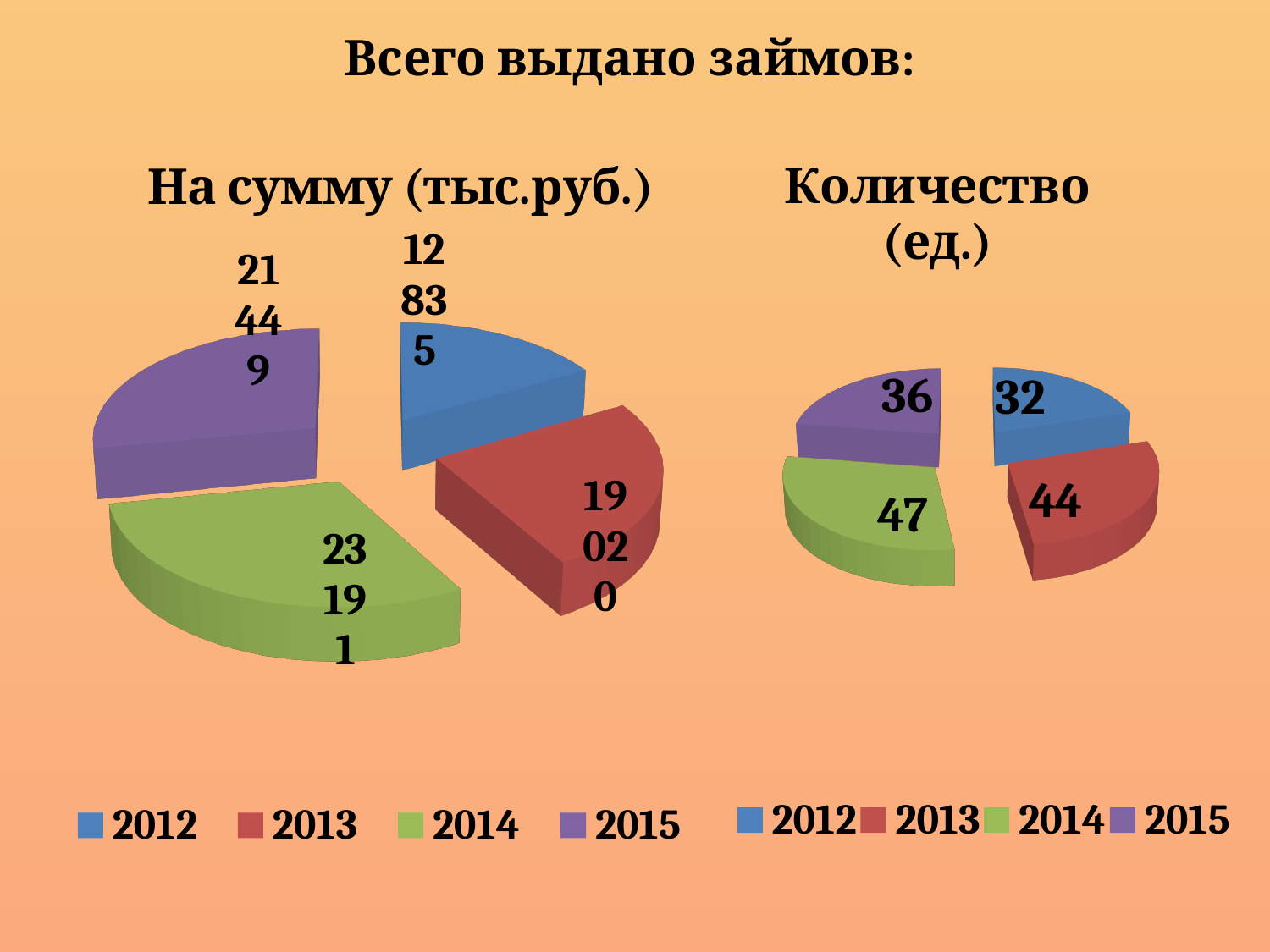
In the "На сумму (тыс.руб.)" chart, which year has the smallest slice? 2012 In the "Количество (ед.)" chart, which is larger, the value for 2013 or the value for 2015? 2013 In the "Количество (ед.)" chart, which year has the lowest value? 2012 In the "Количество (ед.)" chart, which year has the highest value? 2014 In the "Количество (ед.)" chart, what is the value for 2012? 32 In the "Количество (ед.)" chart, what is the value for 2014? 47 What kind of chart is the "Количество (ед.)" chart? pie chart In the "Количество (ед.)" chart, what is the total of all four slices? 159 How many slices does the "На сумму (тыс.руб.)" chart have? 4 In the "Количество (ед.)" chart, what is the difference between the values for 2014 and 2012? 15 How many entries does the legend of the "Количество (ед.)" chart list? 4 In the "На сумму (тыс.руб.)" chart, what is the value for 2014? 23191